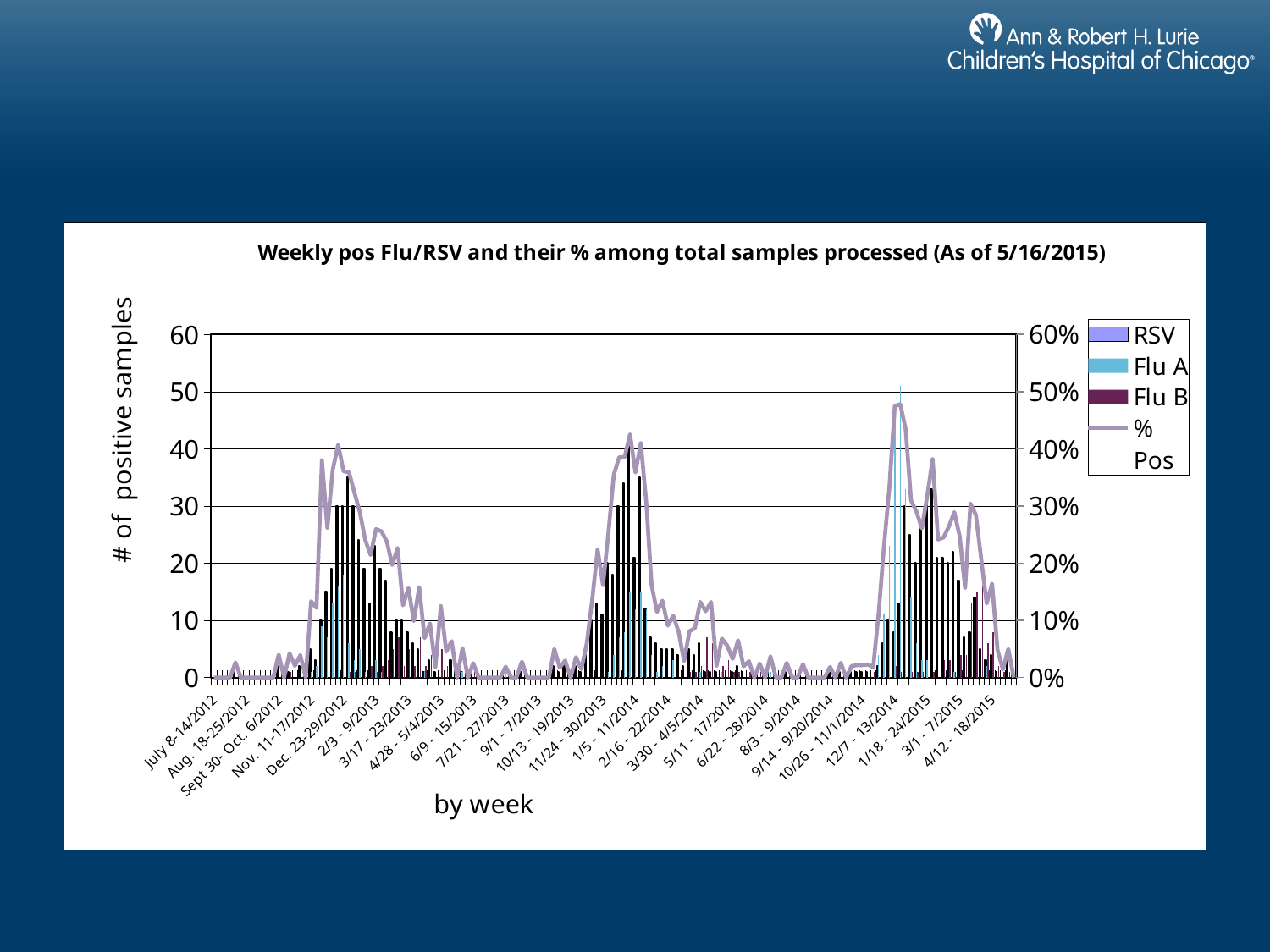
Is the tallest bar in the chart greater or less than 30 positive samples? greater How many series does the legend list? 4 What kind of chart is this? Combination bar and line chart What is the highest tick value shown on the right vertical axis? 60% What is the highest tick value shown on the left vertical axis? 60 Is the highest peak of the % Pos line greater or less than 40%? greater What are the series names listed in the legend? RSV, Flu A, Flu B, % Pos What is the title of the chart? Weekly pos Flu/RSV and their % among total samples processed (As of 5/16/2015) Is the % Pos line around the week of 8/3 - 9/2014 greater or less than 10%? less What is the label of the left vertical axis? # of positive samples